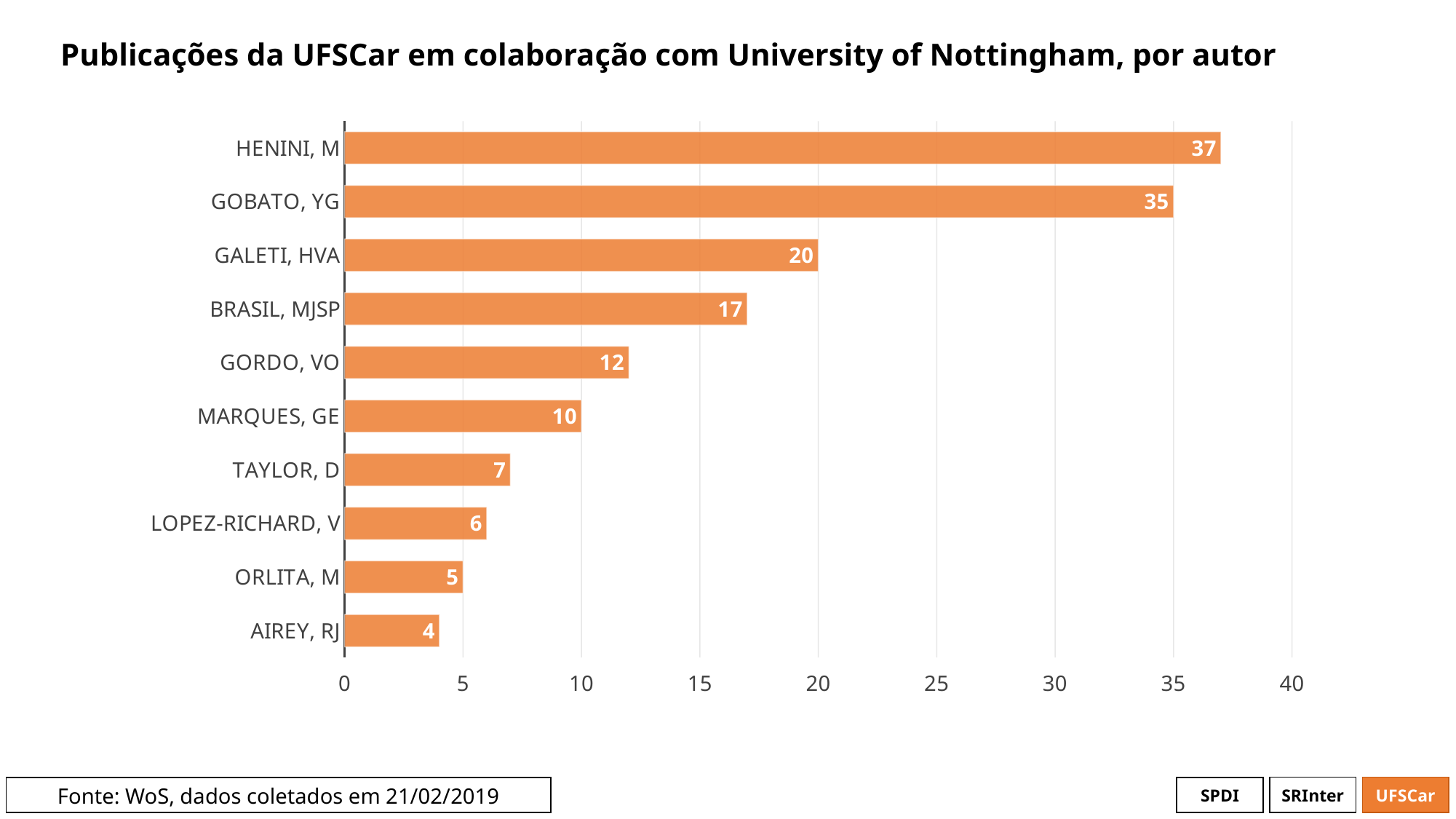
What is the title of the chart? Publicações da UFSCar em colaboração com University of Nottingham, por autor Is the value for BRASIL, MJSP greater or less than 15? greater Which has a larger value, GORDO, VO or MARQUES, GE? GORDO, VO What kind of chart is shown on the slide? bar chart What is the value for ORLITA, M? 5 Which author has the lowest number of publications? AIREY, RJ What is the difference between the values for GALETI, HVA and BRASIL, MJSP? 3 What is the difference between the values for HENINI, M and GOBATO, YG? 2 How many authors are shown in the chart? 10 What is the value for GALETI, HVA? 20 How many publications does HENINI, M have? 37 Which author has the highest number of publications? HENINI, M